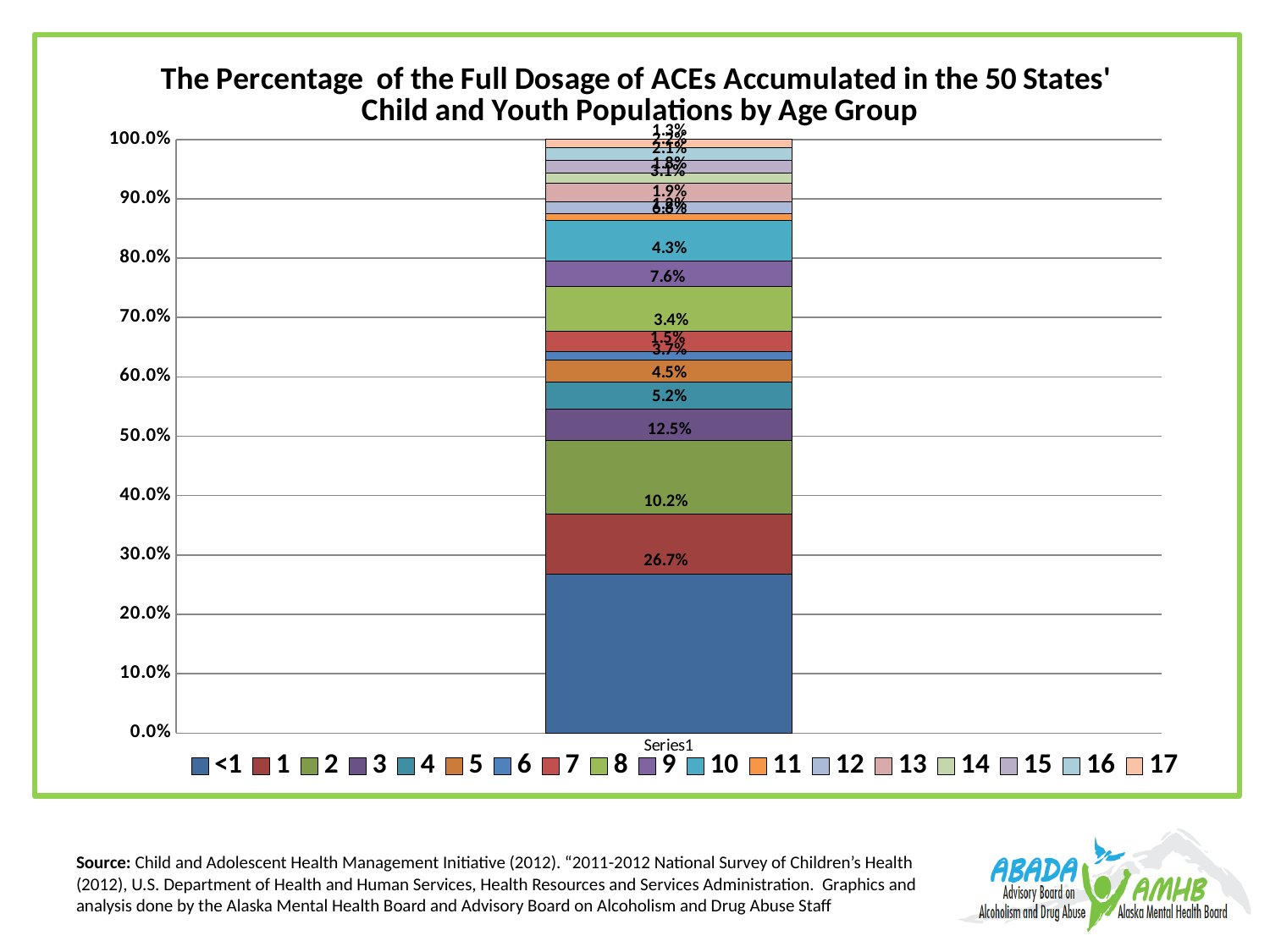
Which segment is larger, the one for age <1 or the one for age 1? <1 Which age group occupies the largest segment of the stacked bar? <1 How many bars are plotted in the chart? 1 Which segment is larger, the one for age <1 or the one for age 3? <1 Is the segment for the <1 age group greater or less than 20%? greater What is the label on the category axis beneath the bar? Series1 What is the first entry listed in the legend? <1 What value does the top of the stacked bar reach on the y axis? 100.0% Does the top of the <1 segment lie above or below the 30.0% gridline? below What kind of chart is shown on the slide? stacked bar chart What is the largest data label printed on the bar? 26.7% How many series does the legend list? 18